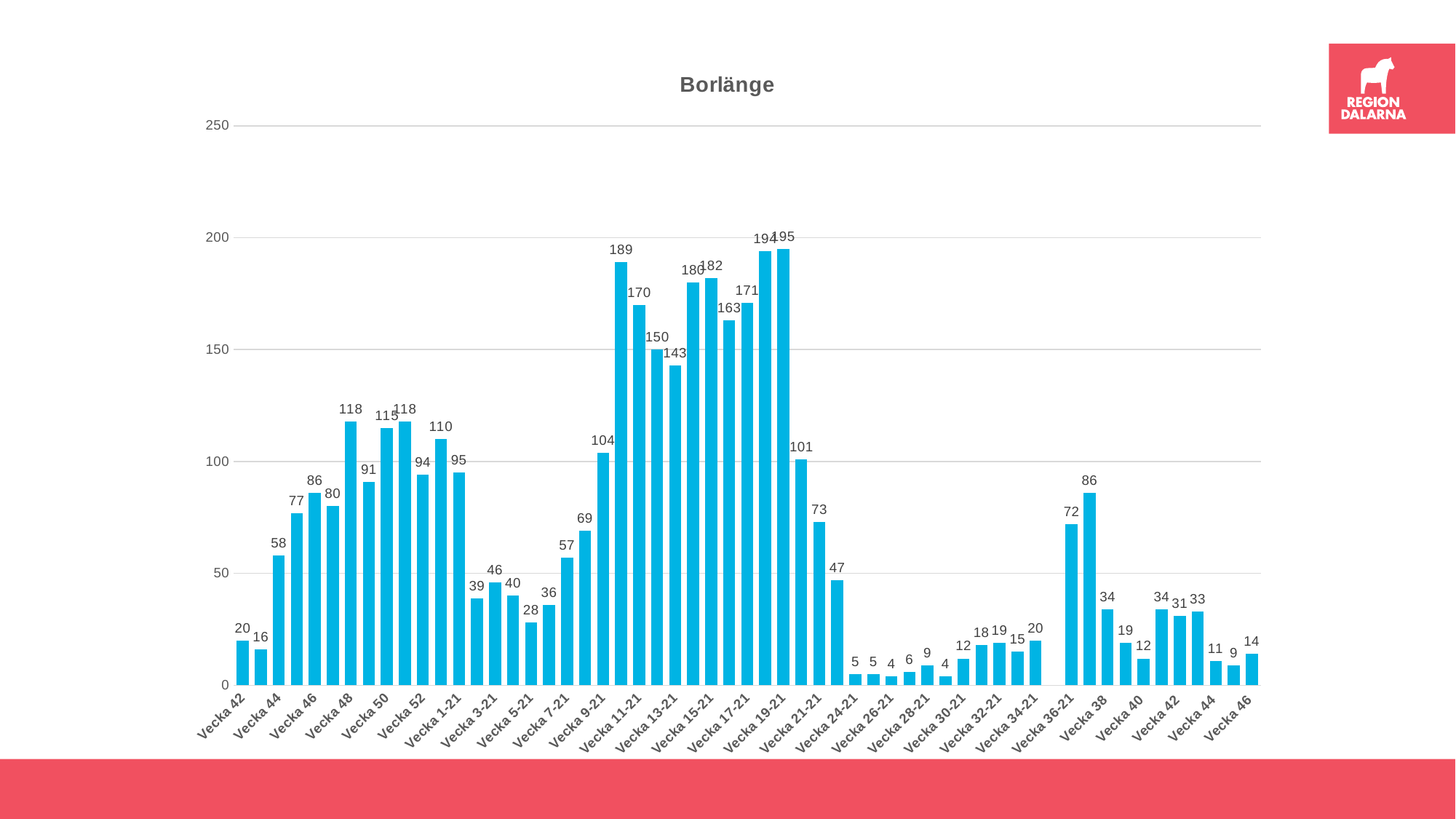
What is the value for Vecka 19-21? 195 What is the value for Vecka 24-21? 5 Do the values rise or fall from Vecka 19-21 to Vecka 24-21? fall What is the lowest value shown in the chart? 4 Which is larger, the value for Vecka 15-21 or the value for Vecka 17-21? Vecka 15-21 What is the title of the chart? Borlänge What is the highest value shown in the chart? 195 What kind of chart is shown on the slide? bar chart What is the value for Vecka 36-21? 72 Is the value for Vecka 13-21 greater or less than 100? greater What is the difference between the values for Vecka 11-21 and Vecka 9-21? 66 What is the value for Vecka 48? 118